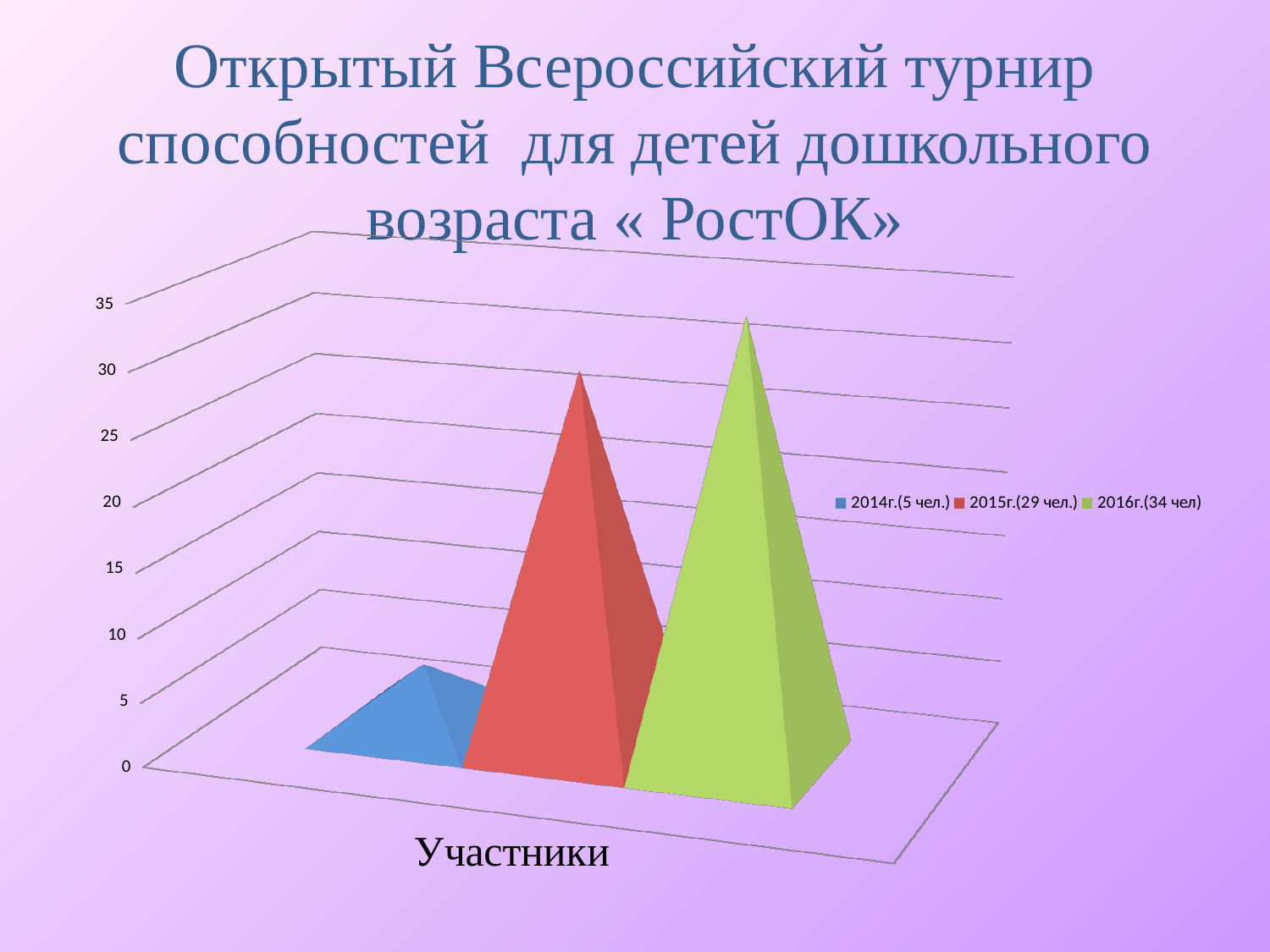
By how many participants does 2016г. exceed 2015г.? 5 Is the value for 2015г. greater or less than 25? greater Which has more participants, 2015г. or 2016г.? 2016г. How many series does the legend list? 3 How many participants does the legend give for 2016г.? 34 чел How many participants does the legend give for 2014г.? 5 чел. Which year has the lowest number of participants? 2014г. What is the label on the horizontal axis of the chart? Участники What is the difference in participants between 2015г. and 2014г.? 24 Which year has the highest number of participants? 2016г. How many participants does the legend give for 2015г.? 29 чел. What kind of chart is shown on the slide? bar chart